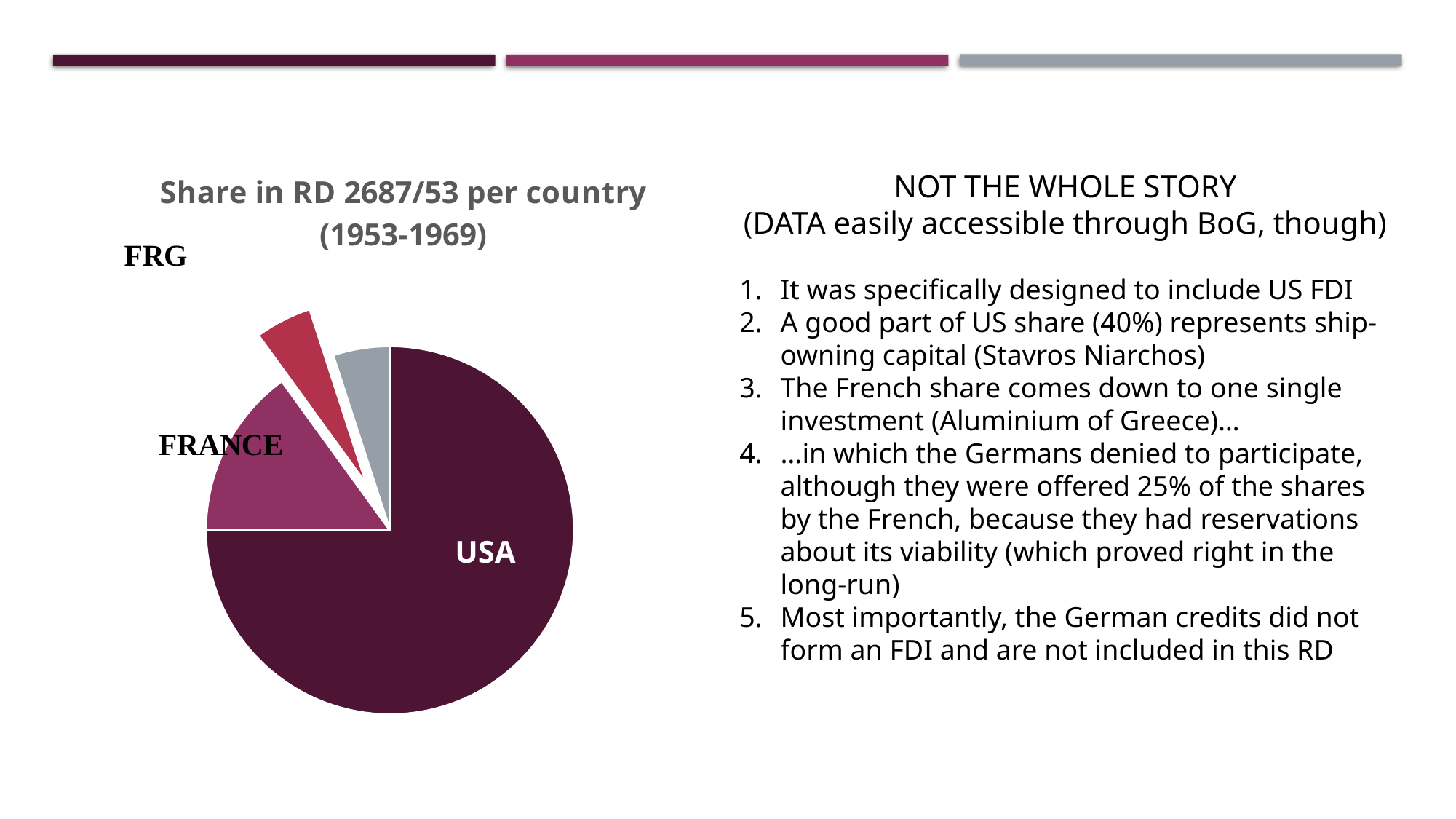
Which country has the largest share in the pie chart? USA Which is larger in the pie chart, the share of FRANCE or the share of FRG? FRANCE Which slice of the pie chart is pulled out (exploded) from the rest of the pie? FRG What is the title of the pie chart? Share in RD 2687/53 per country (1953-1969) Does the USA slice take up more or less than half of the pie chart? more What kind of chart is shown on the slide? pie chart Which is larger in the pie chart, the share of USA or the share of FRANCE? USA How many slices does the pie chart have? 4